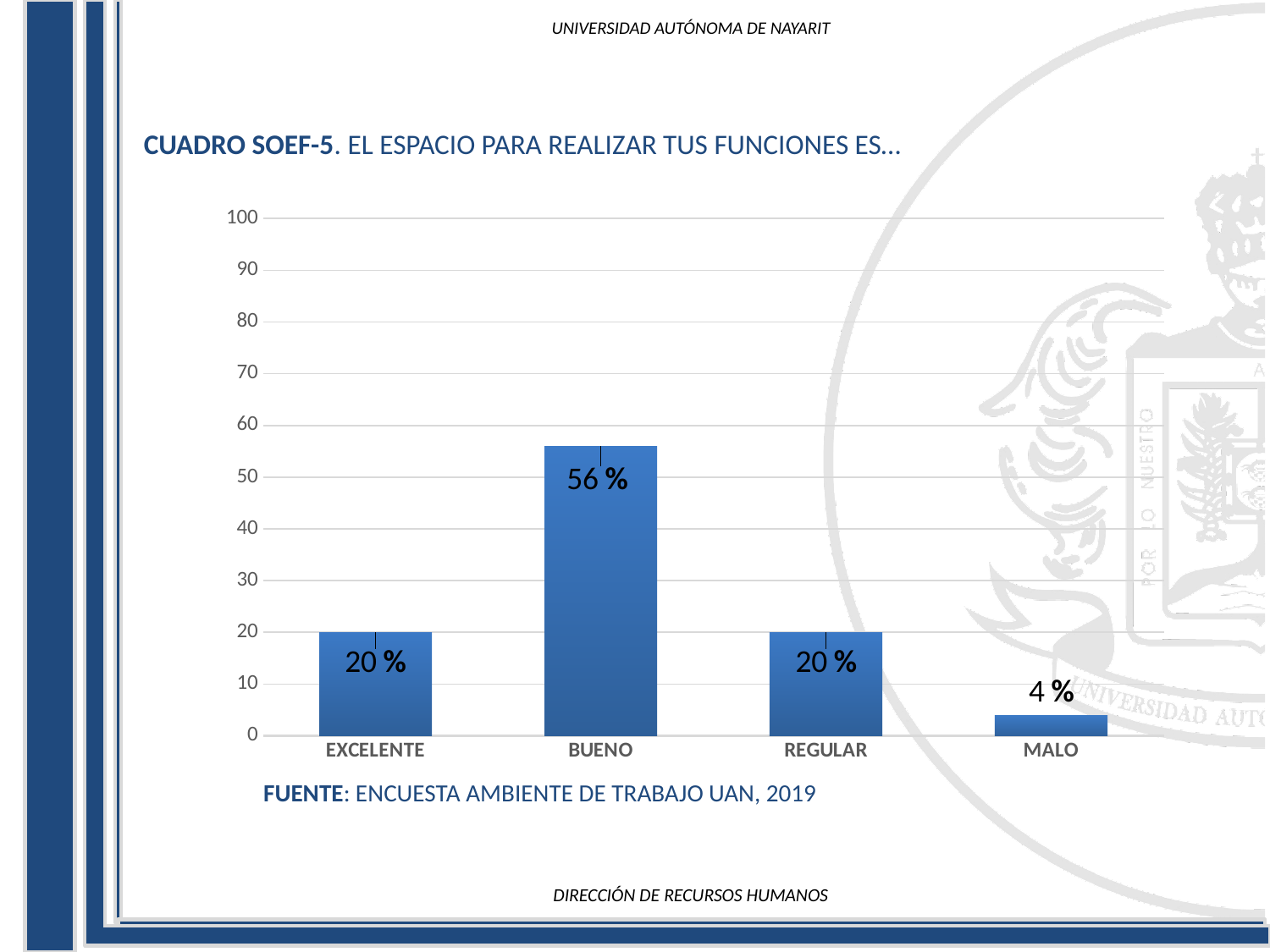
What is the source cited below the chart? ENCUESTA AMBIENTE DE TRABAJO UAN, 2019 Which category has the highest value? BUENO What is the difference between the values for BUENO and REGULAR? 36 % What is the value for MALO? 4 % What kind of chart is shown on the slide? bar chart Which category has the lowest value? MALO What is the value for BUENO? 56 % How many categories are shown on the x axis? 4 Which is larger, the value for BUENO or the value for EXCELENTE? BUENO What is the difference between the values for EXCELENTE and MALO? 16 % Is the value for BUENO greater or less than 50? greater What is the value for EXCELENTE? 20 %